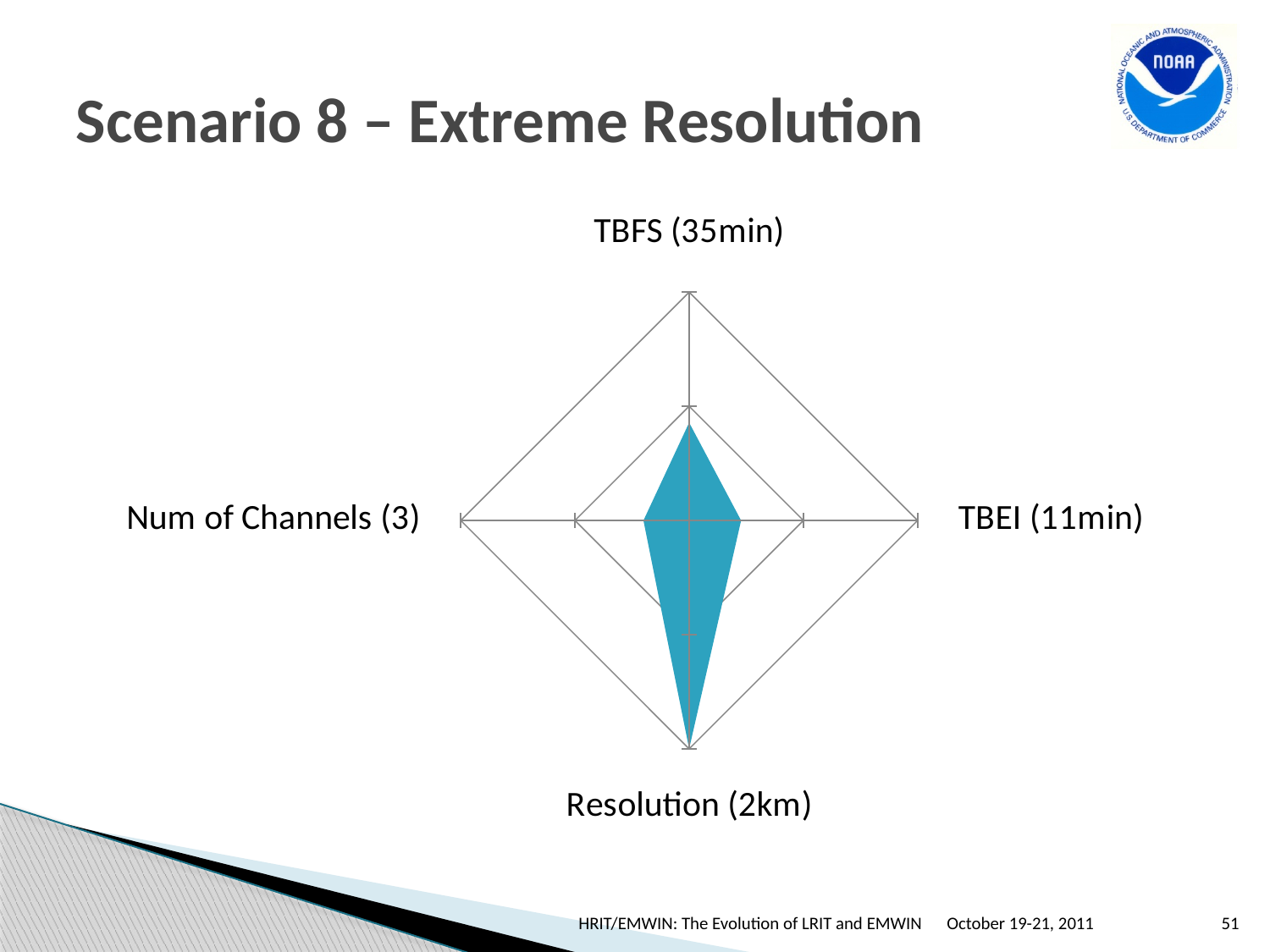
What kind of chart is shown on the slide? Radar chart Which axis label appears at the top of the radar chart? TBFS (35min) Does the filled shape extend further along the TBFS (35min) axis or the TBEI (11min) axis? TBFS (35min) Which axis label appears on the left side of the radar chart? Num of Channels (3) Does the filled shape reach the outer edge of the radar grid on the Resolution (2km) axis? Yes Along which axis does the filled shape extend the furthest from the centre? Resolution (2km) Does the filled shape extend further along the Resolution (2km) axis or the TBFS (35min) axis? Resolution (2km) Does the filled shape extend further along the Resolution (2km) axis or the Num of Channels (3) axis? Resolution (2km) Which axis label appears on the right side of the radar chart? TBEI (11min) What is the title of the slide containing the radar chart? Scenario 8 – Extreme Resolution How many axes (categories) does the radar chart have? 4